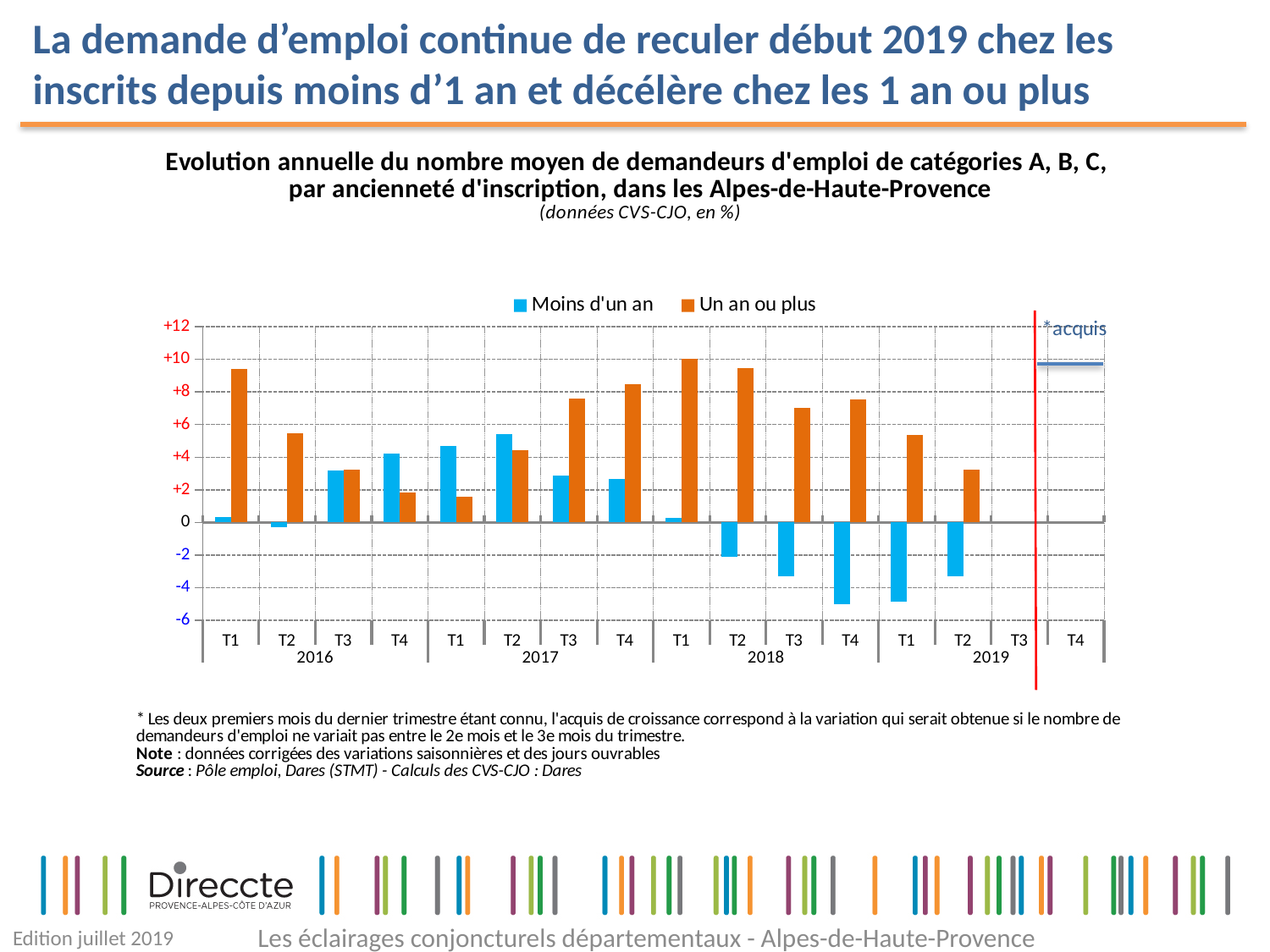
Is the value for 'Moins d'un an' in T4 2018 greater or less than -4? less Does the 'Moins d'un an' series rise or fall from T2 2017 to T4 2018? fall Is the value for 'Un an ou plus' in T4 2016 greater or less than +4? less In which quarter does the 'Moins d'un an' series reach its highest value? T2 2017 What are the two series named in the legend? Moins d'un an; Un an ou plus Is the value for 'Moins d'un an' in T2 2017 greater or less than +4? greater Which series is drawn in orange? Un an ou plus What kind of chart is shown on the slide? bar chart In T1 2017, which series has the larger value, 'Moins d'un an' or 'Un an ou plus'? Moins d'un an How many series does the legend list? 2 In T1 2016, which series has the larger value, 'Moins d'un an' or 'Un an ou plus'? Un an ou plus